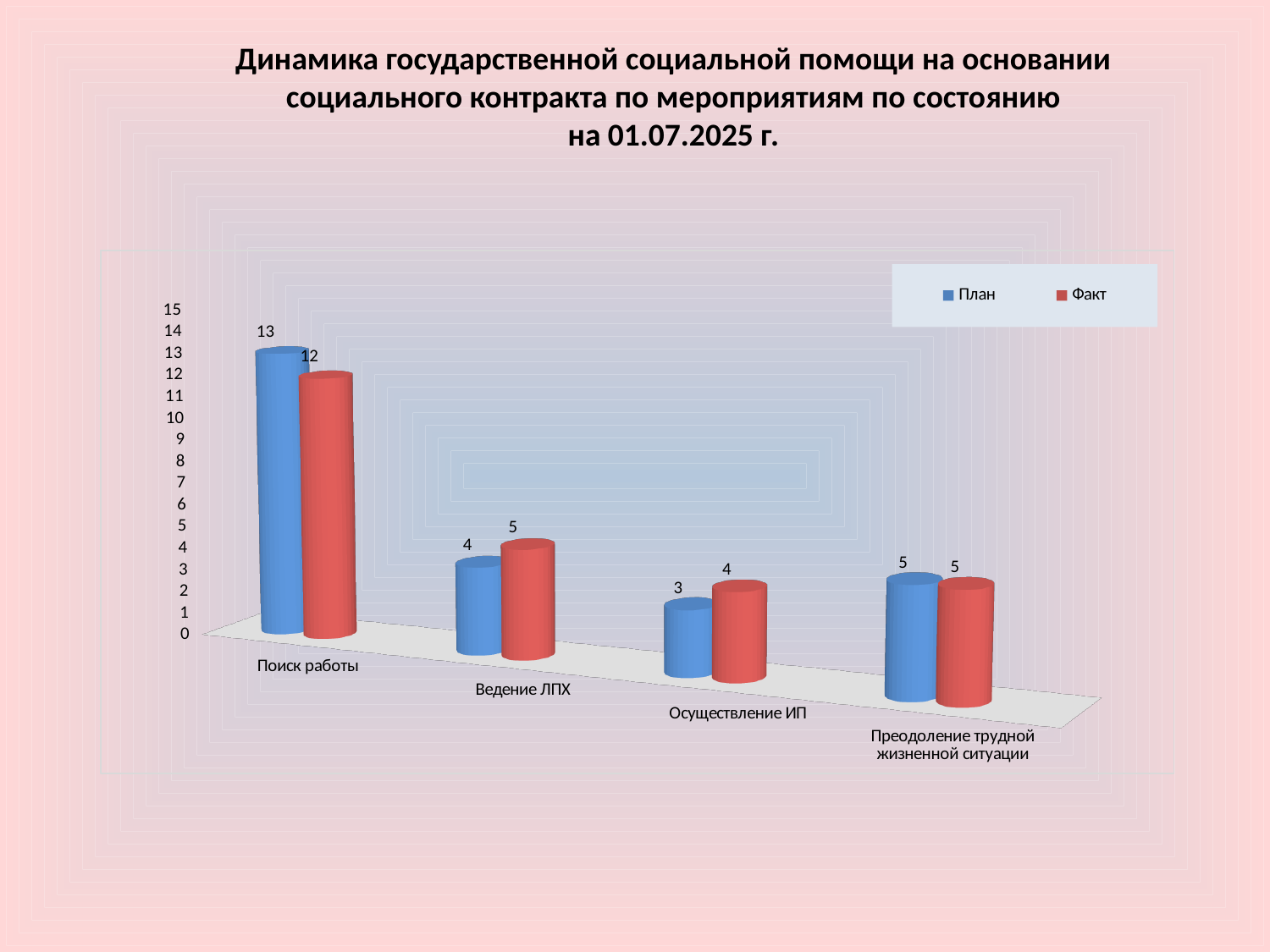
What is the Факт value for Поиск работы? 12 What kind of chart is shown on the slide? Bar chart Which colour represents the Факт series? Red How many categories are shown on the x axis? 4 How many series does the legend list? 2 What is the difference between the План and Факт values for Поиск работы? 1 Which category has the lowest Факт value? Осуществление ИП Which is larger for Ведение ЛПХ, План or Факт? Факт What is the План value for Осуществление ИП? 3 What is the Факт value for Ведение ЛПХ? 5 What is the План value for Поиск работы? 13 Which category has the highest План value? Поиск работы